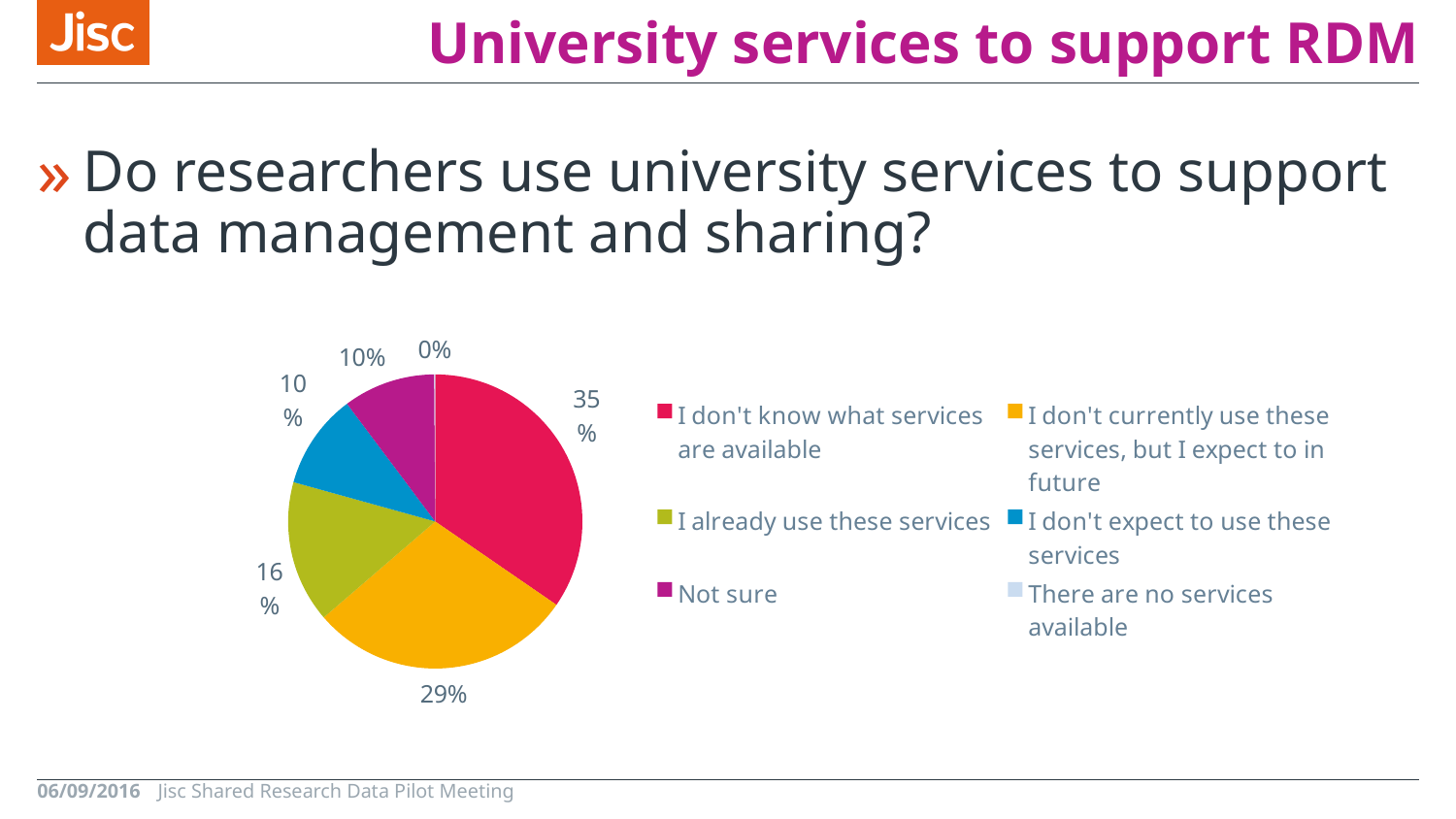
What percentage of respondents said "I don't expect to use these services"? 10% Which is larger: the share for "I don't currently use these services, but I expect to in future" or the share for "I already use these services"? I don't currently use these services, but I expect to in future What percentage of respondents said "There are no services available"? 0% How many entries does the legend list? 6 What colour is the slice for "Not sure"? Purple What percentage of respondents said "I don't currently use these services, but I expect to in future"? 29% What kind of chart is shown on the slide? Pie chart What is the difference in percentage points between "I don't know what services are available" and "I already use these services"? 19 Which response has the smallest share of the pie? There are no services available What percentage of respondents said "I don't know what services are available"? 35% What percentage of respondents said "I already use these services"? 16% Which response has the largest share of the pie? I don't know what services are available